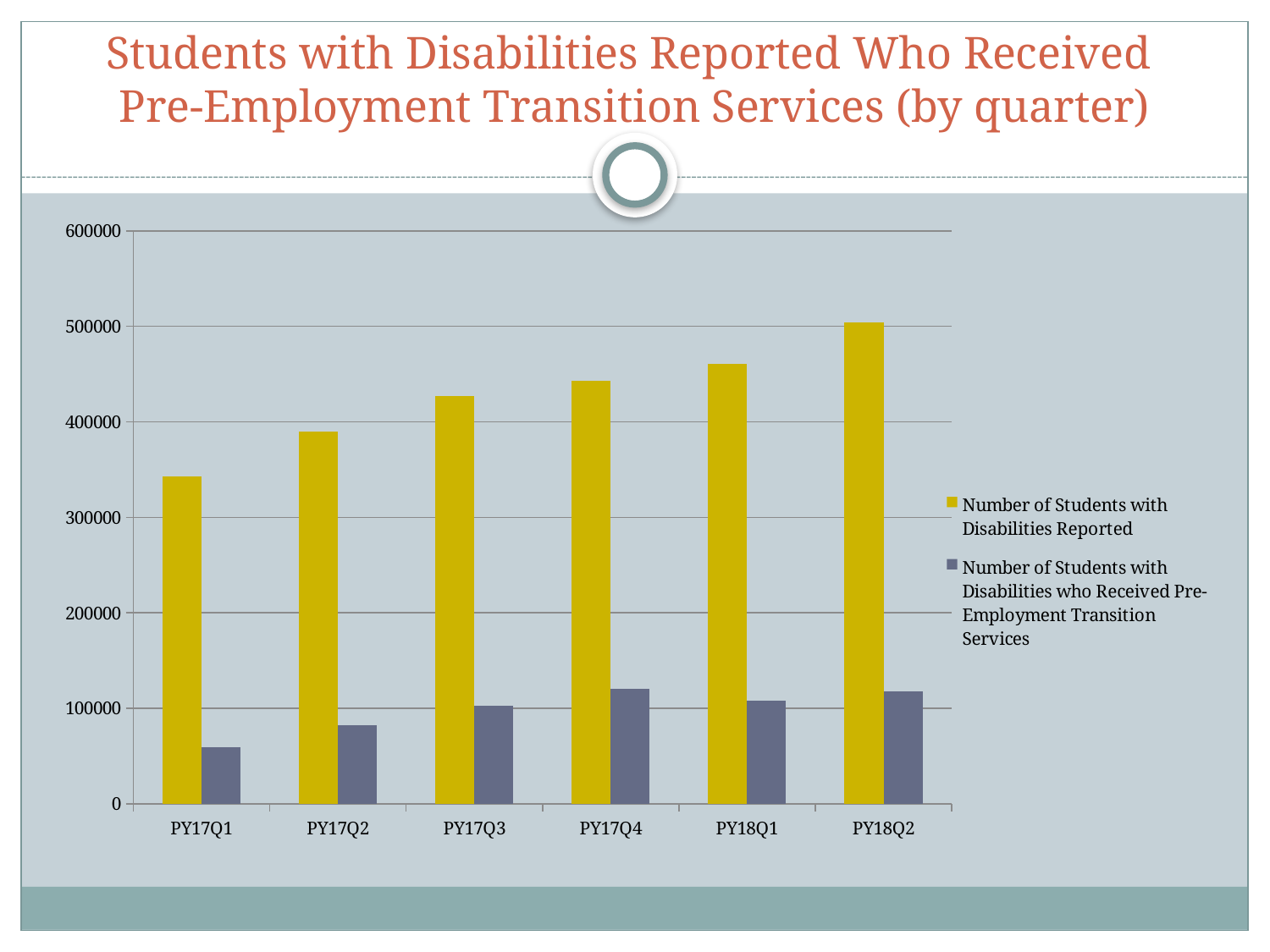
Which quarter has the lowest Number of Students with Disabilities who Received Pre-Employment Transition Services? PY17Q1 Is the Number of Students with Disabilities Reported for PY17Q1 greater or less than 300000? greater What kind of chart is shown on the slide? bar chart How many series does the legend list? 2 Is the Number of Students with Disabilities who Received Pre-Employment Transition Services for PY17Q1 greater or less than 100000? less Is the Number of Students with Disabilities Reported for PY17Q2 greater or less than 400000? less How many quarters are shown on the x axis? 6 Which quarter has the highest Number of Students with Disabilities Reported? PY18Q2 Which is larger, the Number of Students with Disabilities Reported for PY17Q2 or for PY17Q3? PY17Q3 Does the Number of Students with Disabilities Reported rise or fall from PY17Q1 to PY18Q2? rise Which quarter has the lowest Number of Students with Disabilities Reported? PY17Q1